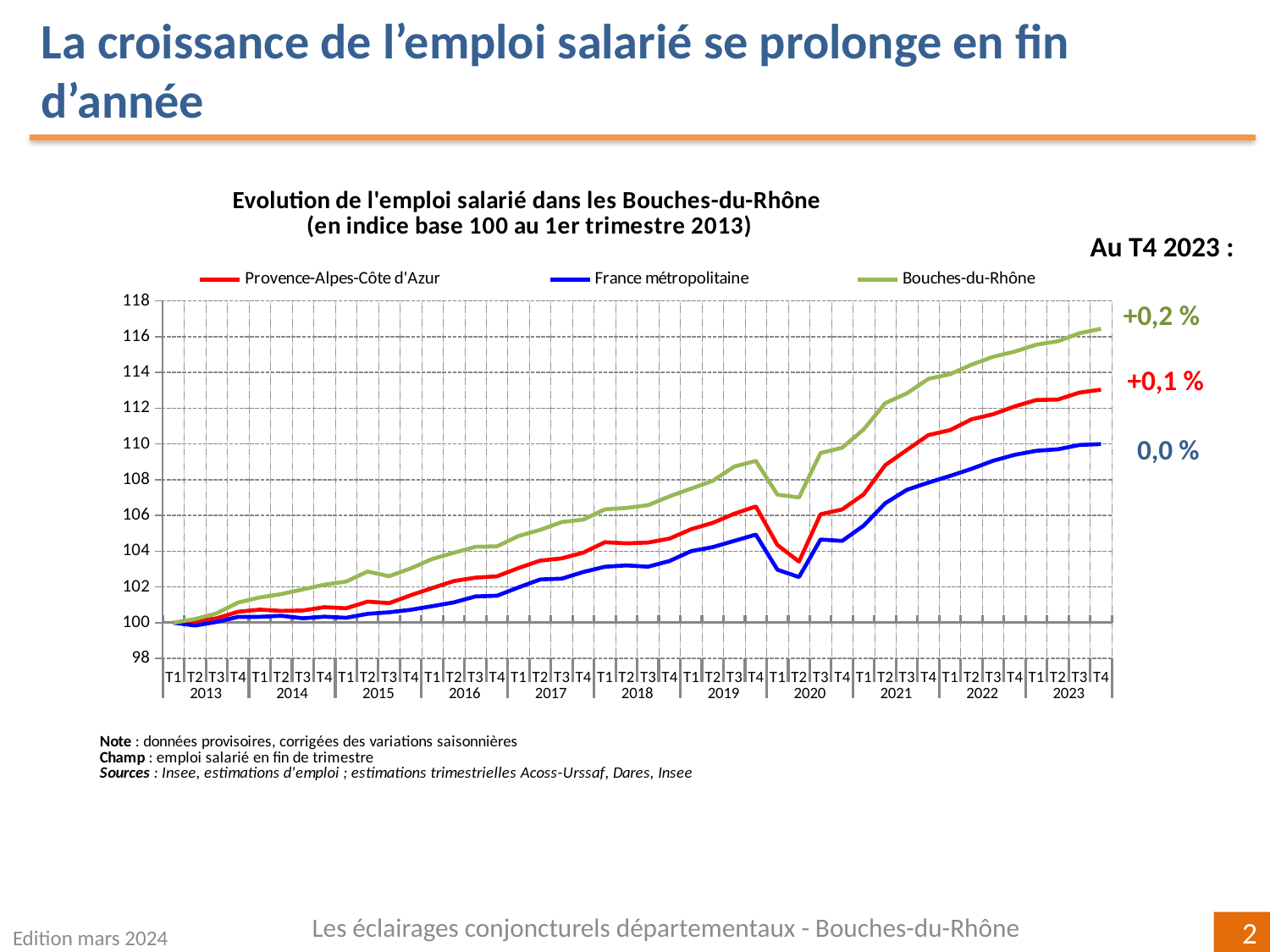
What kind of chart is shown on the slide? line chart What is the title of the chart? Evolution de l'emploi salarié dans les Bouches-du-Rhône (en indice base 100 au 1er trimestre 2013) Is the value for France métropolitaine at T2 2020 greater or less than 104? less Which series has the lowest value at T4 2023? France métropolitaine Which series has the highest value at T4 2023? Bouches-du-Rhône Which series is drawn in green? Bouches-du-Rhône What quarterly change is annotated for Bouches-du-Rhône at T4 2023? +0,2 % At T2 2020, which is higher: Bouches-du-Rhône or France métropolitaine? Bouches-du-Rhône Do the values for Bouches-du-Rhône rise or fall overall from 2013 to 2023? rise How many series does the legend list? 3 Is the value for Bouches-du-Rhône at T4 2023 greater or less than 114? greater Is the value for France métropolitaine at T4 2023 greater or less than 112? less